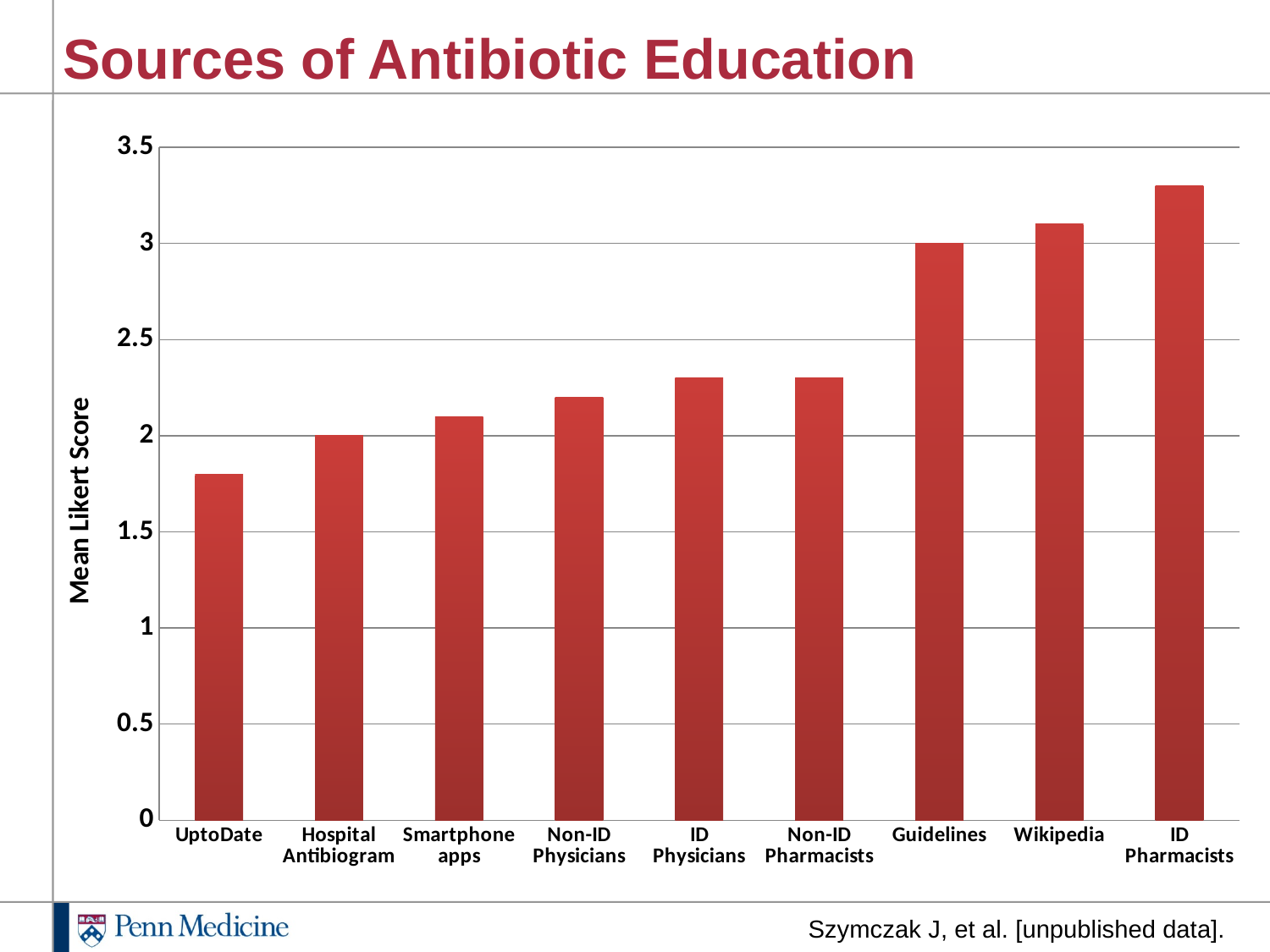
What is the mean Likert score for Hospital Antibiogram? 2 What type of chart is shown on the slide? Bar chart Is the value for Non-ID Physicians greater or less than 2.5? less What is the mean Likert score for Guidelines? 3 Which source has the lowest mean Likert score? UptoDate Which has a higher mean Likert score, UptoDate or Smartphone apps? Smartphone apps Which source has the highest mean Likert score? ID Pharmacists Is the value for UptoDate greater or less than 2? less How many sources of antibiotic education are shown on the x axis? 9 What is the label on the vertical axis? Mean Likert Score Do the values generally rise or fall moving from left to right along the x axis? Rise Is the value for ID Pharmacists greater or less than 3? greater